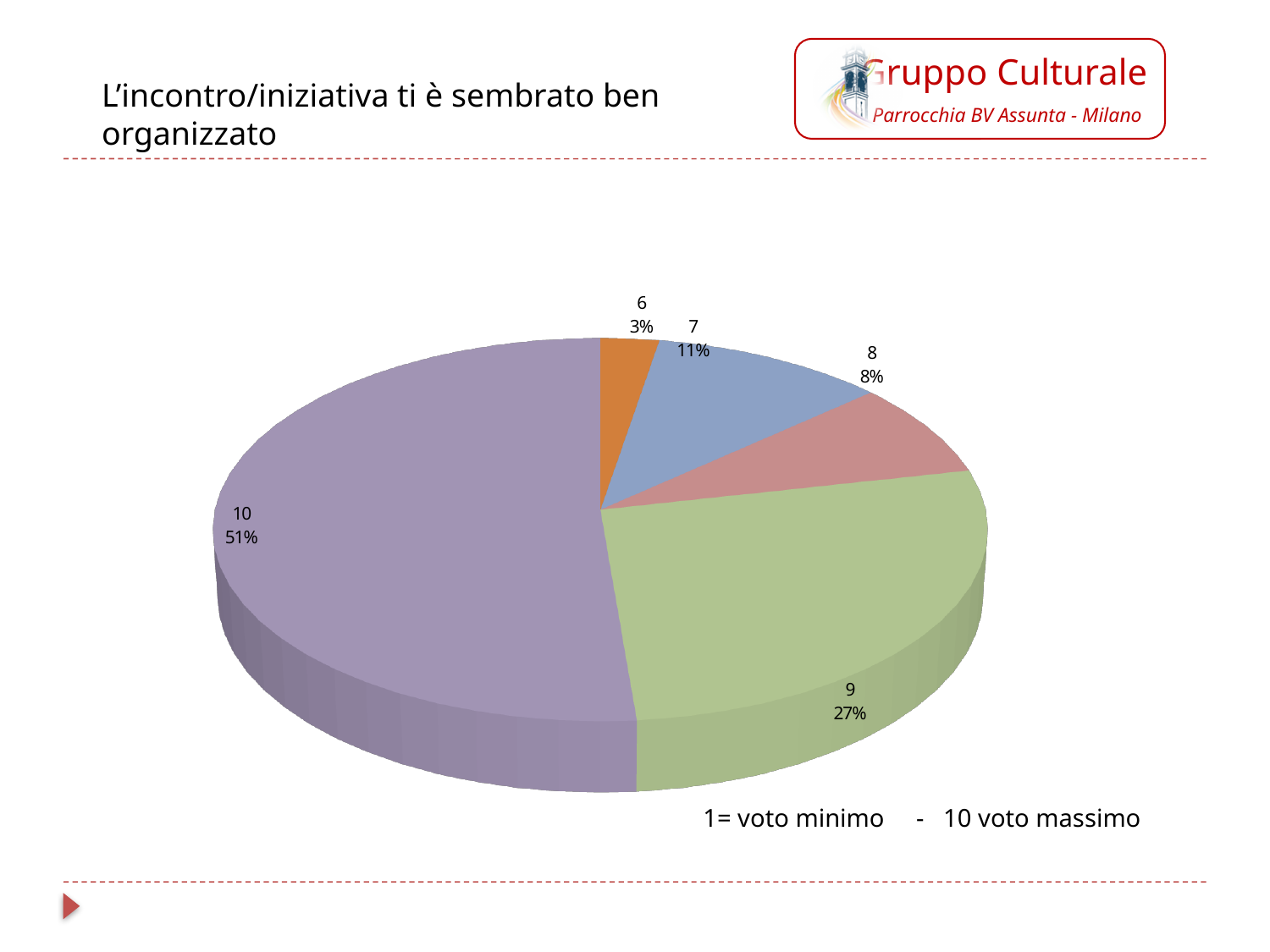
What is the combined share of the slices for vote 9 and vote 10? 78% How many slices does the pie chart have? 5 What percentage is shown for vote 6? 3% What percentage is shown for vote 7? 11% What share of the pie does the slice for vote 10 represent? 51% What is the difference in percentage points between the slices for vote 10 and vote 9? 24 Which vote has the smallest slice of the pie? 6 What share of the pie does the slice for vote 9 represent? 27% What kind of chart is shown on the slide? pie chart What percentage is shown for vote 8? 8% Which slice is larger, vote 7 or vote 8? 7 Which vote has the largest slice of the pie? 10